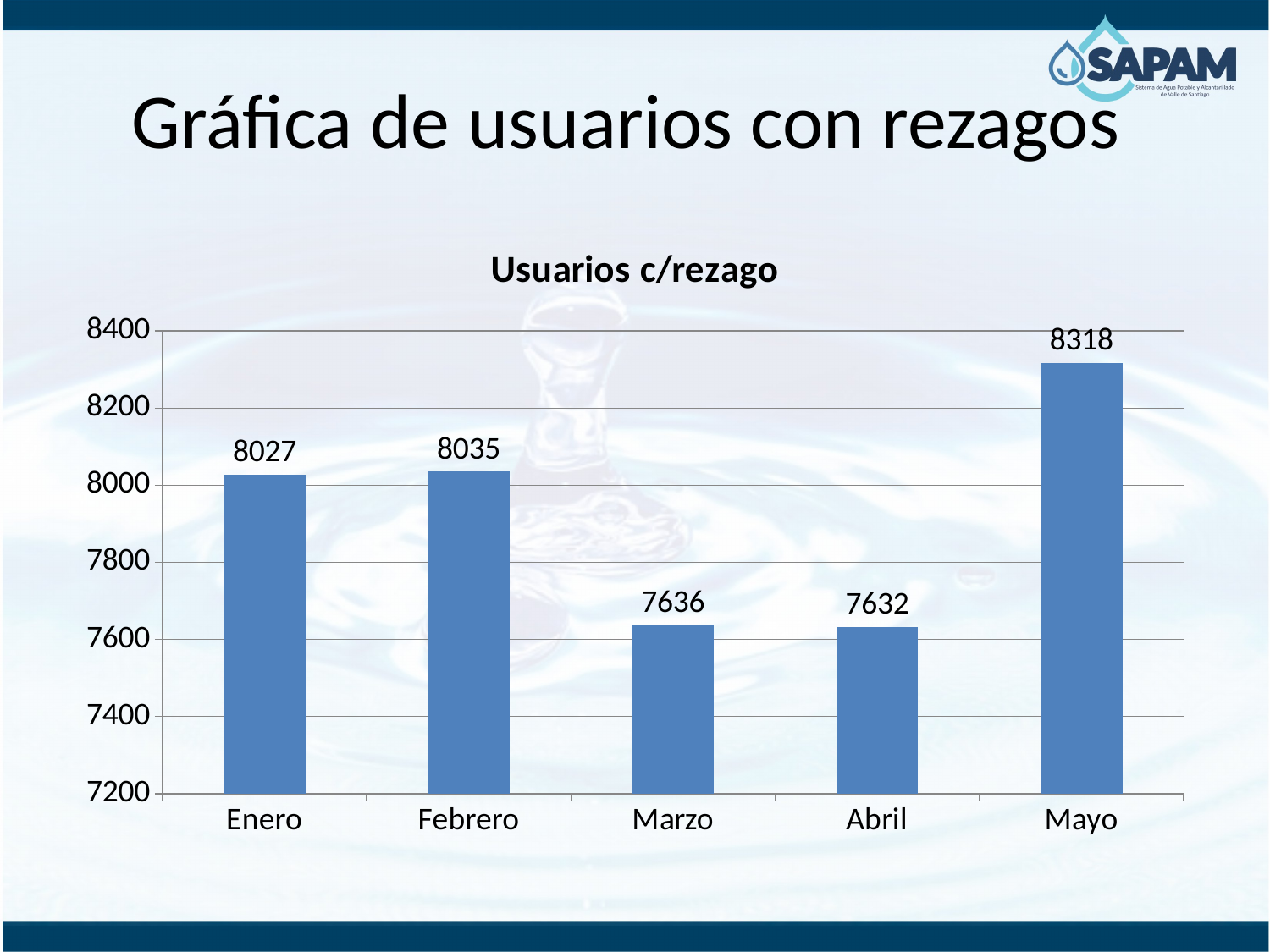
Which is larger, the value for Enero or the value for Marzo? Enero Which month has the lowest value? Abril How many months are shown on the x axis? 5 What is the value for Mayo? 8318 What kind of chart is shown on the slide? bar chart Which month has the highest value? Mayo What is the difference between the values for Mayo and Abril? 686 What is the value for Marzo? 7636 What is the value for Enero? 8027 What is the difference between the values for Febrero and Enero? 8 Is the value for Mayo greater or less than 8200? greater What is the title of the chart? Usuarios c/rezago